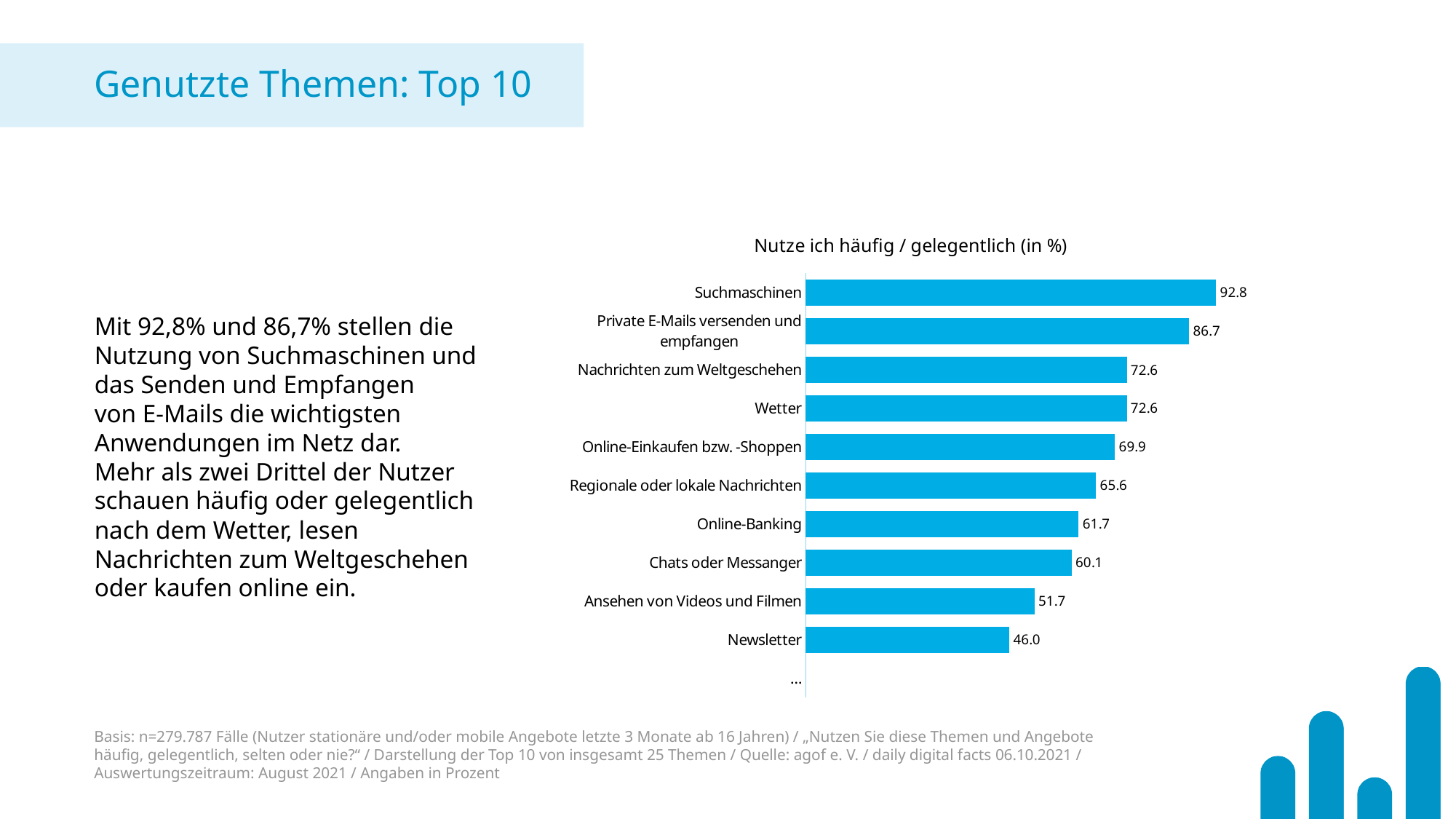
Which two categories share the same value of 72.6? Nachrichten zum Weltgeschehen and Wetter What is the value for Suchmaschinen? 92.8 What is the value for Online-Banking? 61.7 Which is larger, the value for Online-Einkaufen bzw. -Shoppen or the value for Regionale oder lokale Nachrichten? Online-Einkaufen bzw. -Shoppen What is the title of the chart? Nutze ich häufig / gelegentlich (in %) What is the difference between the values for Suchmaschinen and Private E-Mails versenden und empfangen? 6.1 What is the value for Newsletter? 46.0 What kind of chart is shown on the slide? Bar chart How many labelled categories with bars are shown in the chart? 10 Which category has the highest value? Suchmaschinen Which labelled category has the lowest value? Newsletter What is the value for Ansehen von Videos und Filmen? 51.7